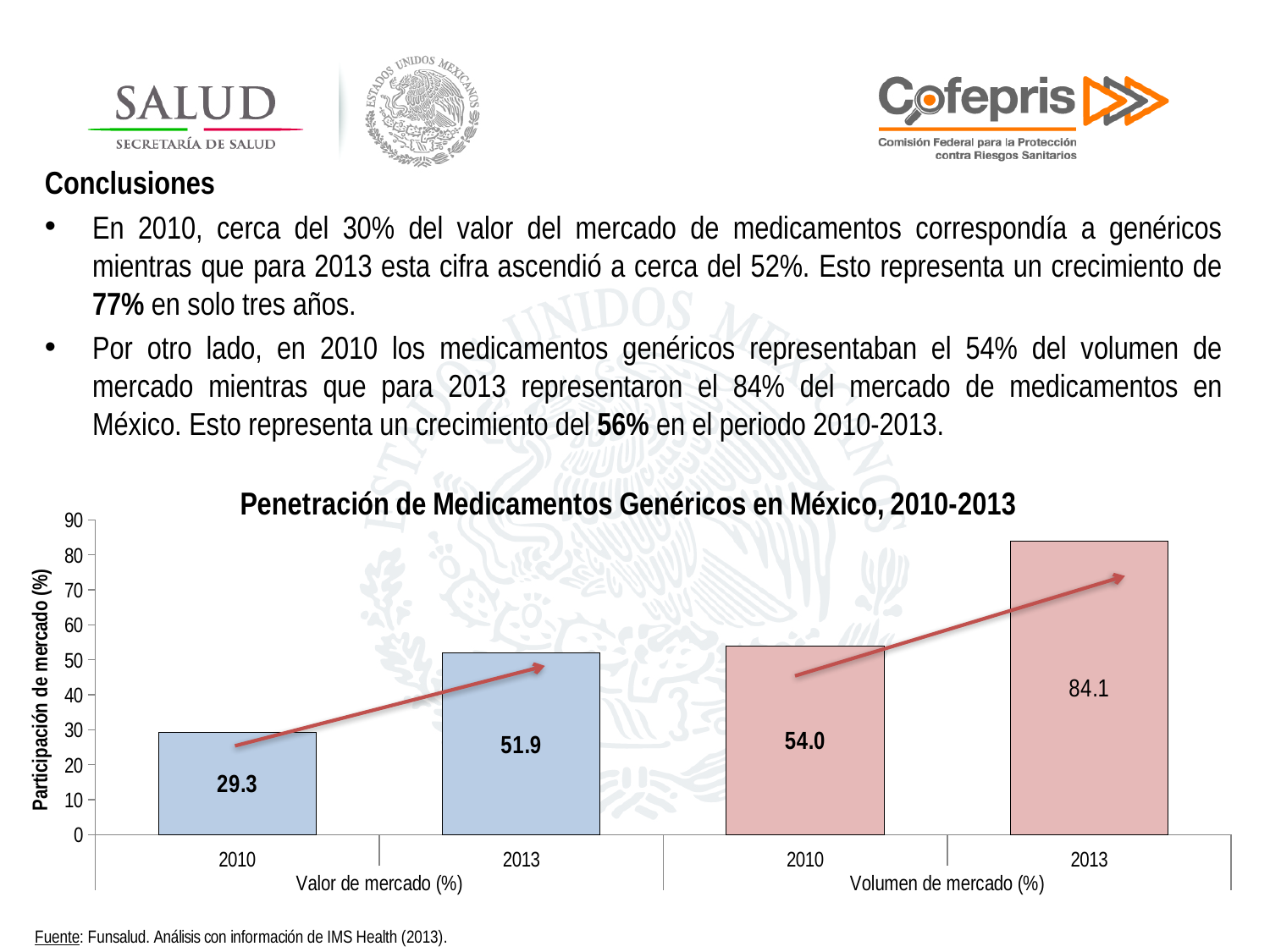
Which bar has the lowest value? 2010, Valor de mercado (%) What is the value for 2010 under Valor de mercado (%)? 29.3 What is the difference between the 2013 and 2010 values for Volumen de mercado (%)? 30.1 Which bar has the highest value? 2013, Volumen de mercado (%) What is the difference between the 2013 and 2010 values for Valor de mercado (%)? 22.6 Which is larger: the 2013 value for Valor de mercado (%) or the 2010 value for Volumen de mercado (%)? 2010 Volumen de mercado (%) What kind of chart is shown? Bar chart What is the value for 2013 under Volumen de mercado (%)? 84.1 How many bars are plotted in the chart? 4 Do the values rise or fall from 2010 to 2013 within each group? Rise What is the title of the chart? Penetración de Medicamentos Genéricos en México, 2010-2013 What is the value for 2010 under Volumen de mercado (%)? 54.0